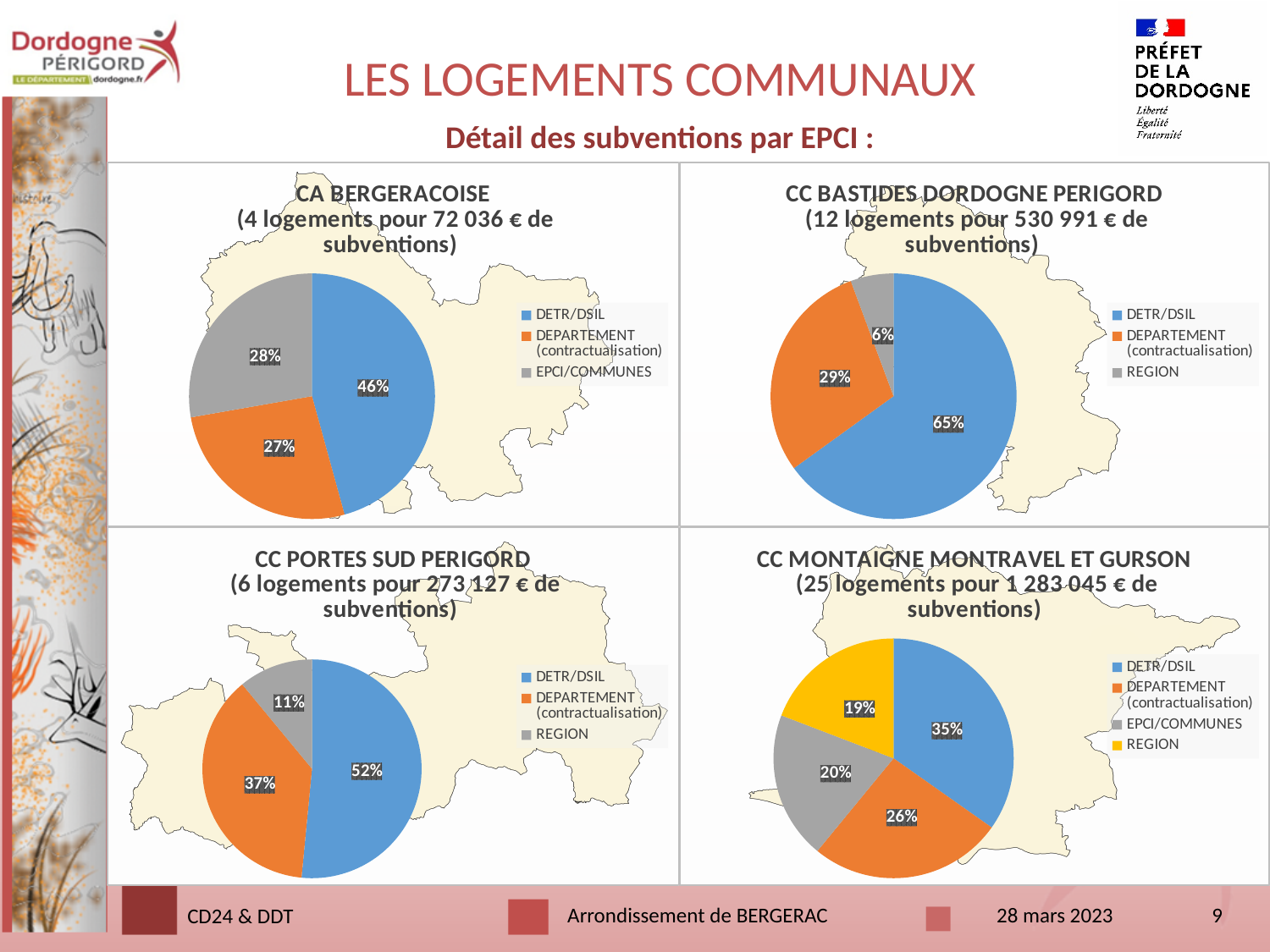
In the CC BASTIDES DORDOGNE PERIGORD chart, what share is attributed to REGION? 6% In the CA BERGERACOISE chart, which is larger: the DETR/DSIL share or the EPCI/COMMUNES share? DETR/DSIL In the CA BERGERACOISE chart, what share of subsidies comes from DETR/DSIL? 46% In the CC BASTIDES DORDOGNE PERIGORD chart, what is the difference between the DETR/DSIL share and the DEPARTEMENT (contractualisation) share? 36 percentage points In the CC MONTAIGNE MONTRAVEL ET GURSON chart, what share is attributed to EPCI/COMMUNES? 20% What type of chart is used for CA BERGERACOISE? Pie chart In the CC PORTES SUD PERIGORD chart, which funding source has the smallest share? REGION In the CC PORTES SUD PERIGORD chart, what share is attributed to DEPARTEMENT (contractualisation)? 37% How many slices does the CC MONTAIGNE MONTRAVEL ET GURSON chart have? 4 In the CC BASTIDES DORDOGNE PERIGORD chart, which funding source has the largest share? DETR/DSIL In the CC MONTAIGNE MONTRAVEL ET GURSON chart, which funding source has the largest share? DETR/DSIL How many entries does the legend of the CC PORTES SUD PERIGORD chart list? 3